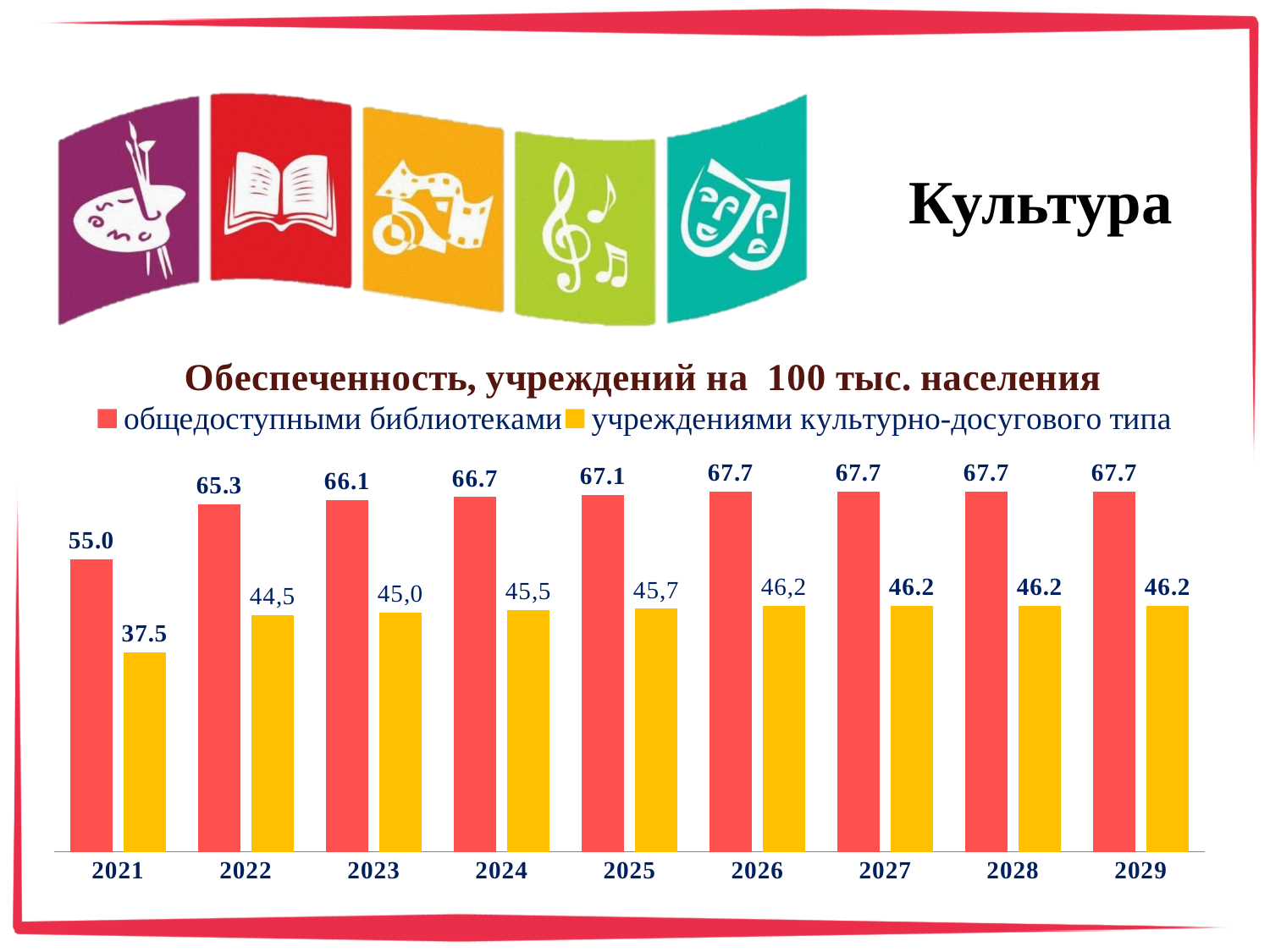
What is the value for учреждениями культурно-досугового типа in 2024? 45,5 In which year is the value for учреждениями культурно-досугового типа lowest? 2021 What is the value for общедоступными библиотеками in 2025? 67.1 What kind of chart is shown on the slide? bar chart How many series does the chart legend list? 2 What is the value for общедоступными библиотеками in 2021? 55.0 What is the value for учреждениями культурно-досугового типа in 2021? 37.5 Which is larger in 2023: the value for общедоступными библиотеками or for учреждениями культурно-досугового типа? общедоступными библиотеками Do the values for общедоступными библиотеками rise or fall from 2021 to 2026? rise What is the difference between the общедоступными библиотеками values for 2022 and 2021? 10.3 What is the difference between the общедоступными библиотеками and учреждениями культурно-досугового типа values in 2029? 21.5 How many years are shown on the x axis of the chart? 9